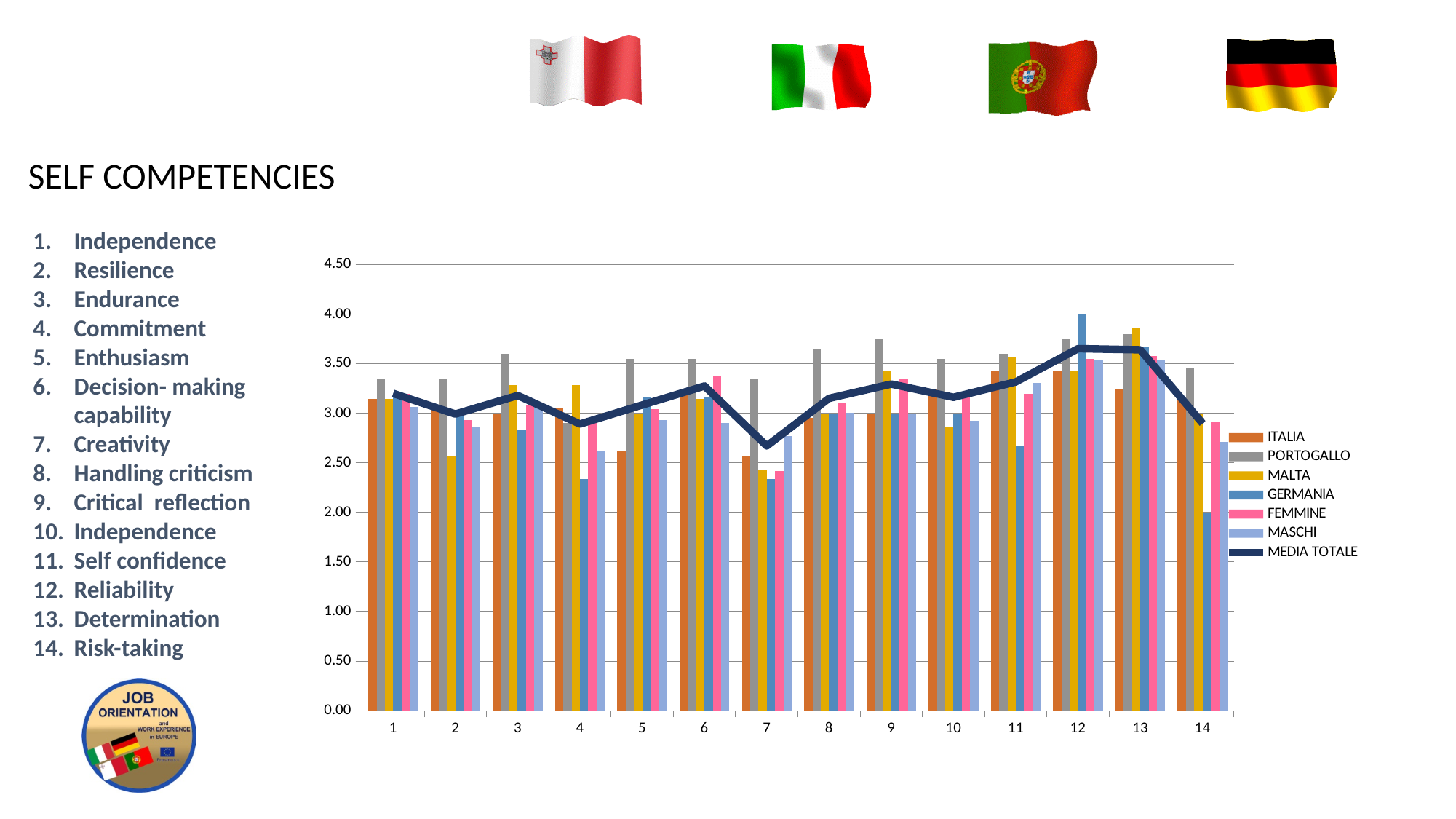
What kind of chart is shown on the slide? combination bar and line chart For category 4, which is larger, the MALTA bar or the GERMANIA bar? MALTA How many categories are shown along the x axis of the chart? 14 For which category is the GERMANIA bar highest? 12 Which series is drawn as a dark line rather than bars? MEDIA TOTALE For which category is the MEDIA TOTALE line at its lowest point? 7 Is the PORTOGALLO value for category 9 greater or less than 3.50? greater For which category is the GERMANIA bar lowest? 14 What is the value of the GERMANIA bar for category 14? 2.00 How many series does the chart legend list? 7 Is the GERMANIA value for category 4 greater or less than 2.50? less What is the value of the GERMANIA bar for category 12? 4.00